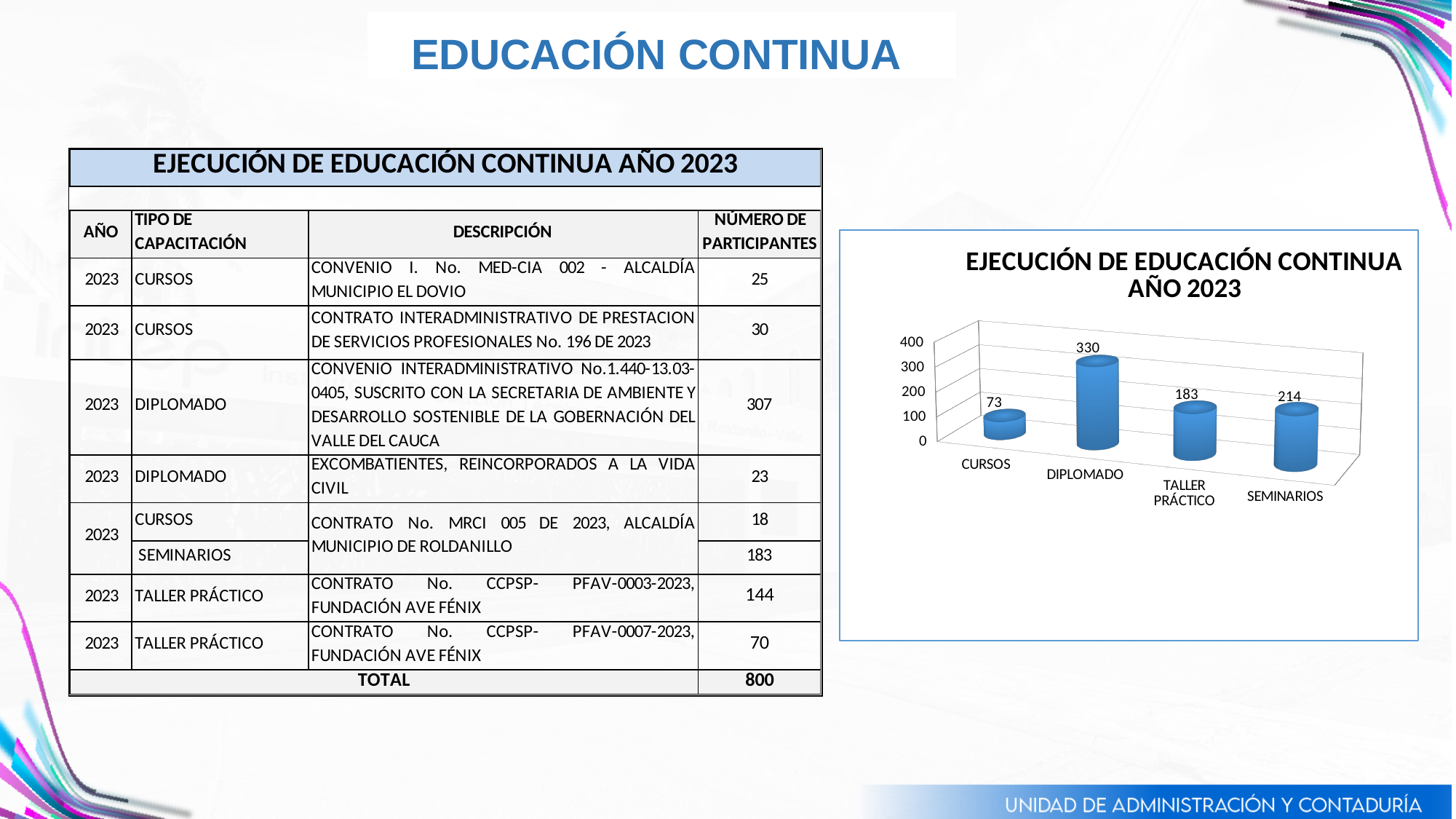
What is the difference between the values for SEMINARIOS and TALLER PRÁCTICO in the chart? 31 Which category has the highest value in the chart? DIPLOMADO Which is larger in the chart, SEMINARIOS or TALLER PRÁCTICO? SEMINARIOS What is the value for SEMINARIOS in the chart? 214 How many categories are shown in the chart? 4 What is the value for DIPLOMADO in the chart? 330 Which category has the lowest value in the chart? CURSOS What is the difference between the values for DIPLOMADO and CURSOS in the chart? 257 What is the value for TALLER PRÁCTICO in the chart? 183 What is the title of the chart? EJECUCIÓN DE EDUCACIÓN CONTINUA AÑO 2023 What kind of chart is shown on the slide? Bar chart What is the value for CURSOS in the chart? 73